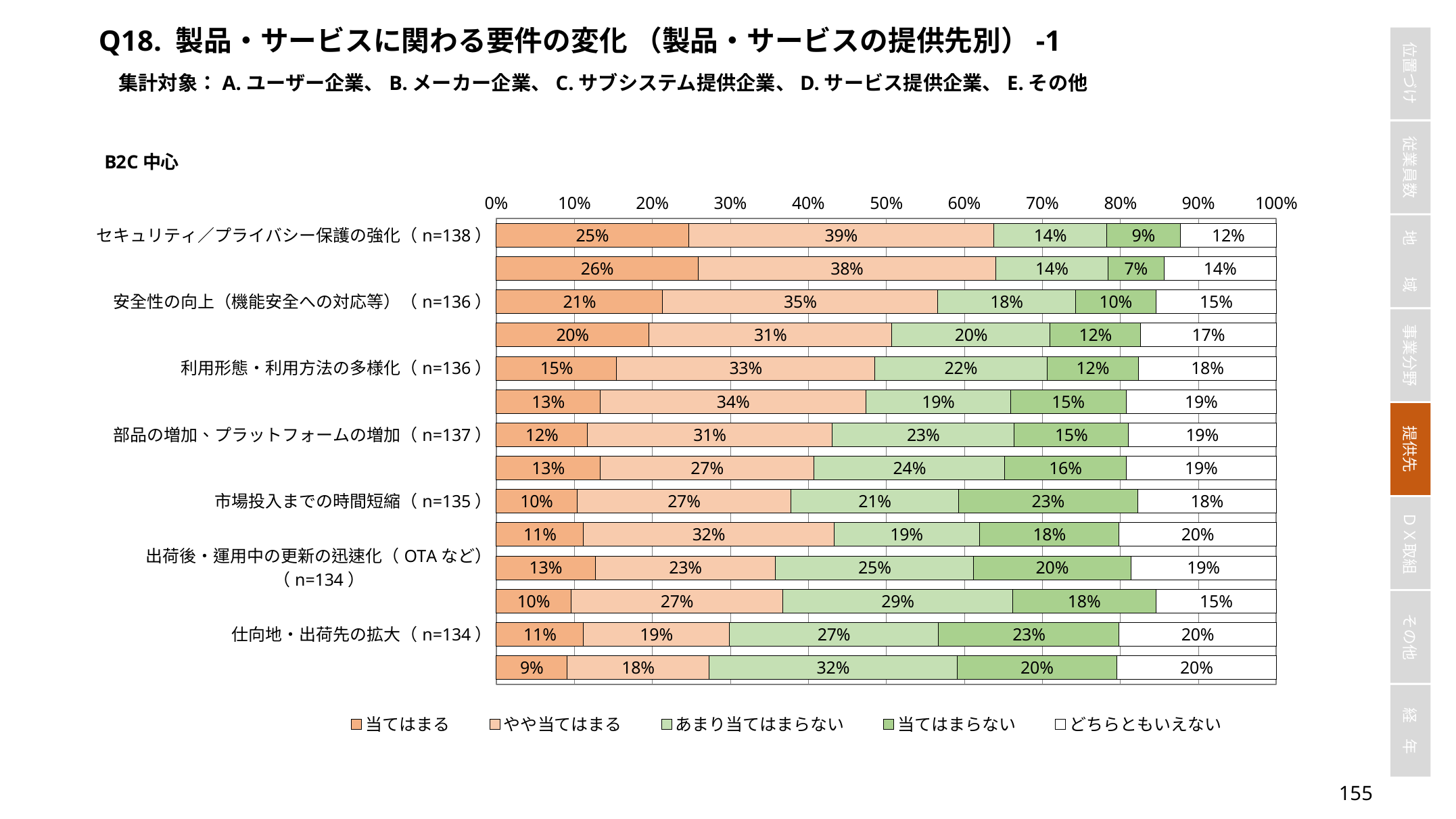
How many bars are plotted in the chart? 14 In the bar directly beside the label 部品の増加、プラットフォームの増加 (n=137), what is the value for 当てはまらない? 15% What kind of chart is shown on the slide? Stacked horizontal bar chart In the bar directly beside the label 仕向地・出荷先の拡大 (n=134), what is the value for どちらともいえない? 20% What colour represents the 当てはまる series in the legend? Orange In the bar directly beside the label 安全性の向上（機能安全への対応等）(n=136), what is the value for やや当てはまる? 35% What is the difference between the 当てはまる value in the bar beside セキュリティ／プライバシー保護の強化 (25%) and the 当てはまる value in the bar beside 仕向地・出荷先の拡大 (11%)? 14 percentage points Among the bars directly beside the category labels, which category has the highest 当てはまる value? セキュリティ／プライバシー保護の強化 In the bar directly beside the label 出荷後・運用中の更新の迅速化（OTA など）(n=134), what is the value for あまり当てはまらない? 25% In the bar directly beside the label セキュリティ／プライバシー保護の強化 (n=138), what is the value for 当てはまる? 25% Which has the larger 当てはまらない value: the bar beside 市場投入までの時間短縮 or the bar beside 利用形態・利用方法の多様化? 市場投入までの時間短縮 How many series does the legend list? 5